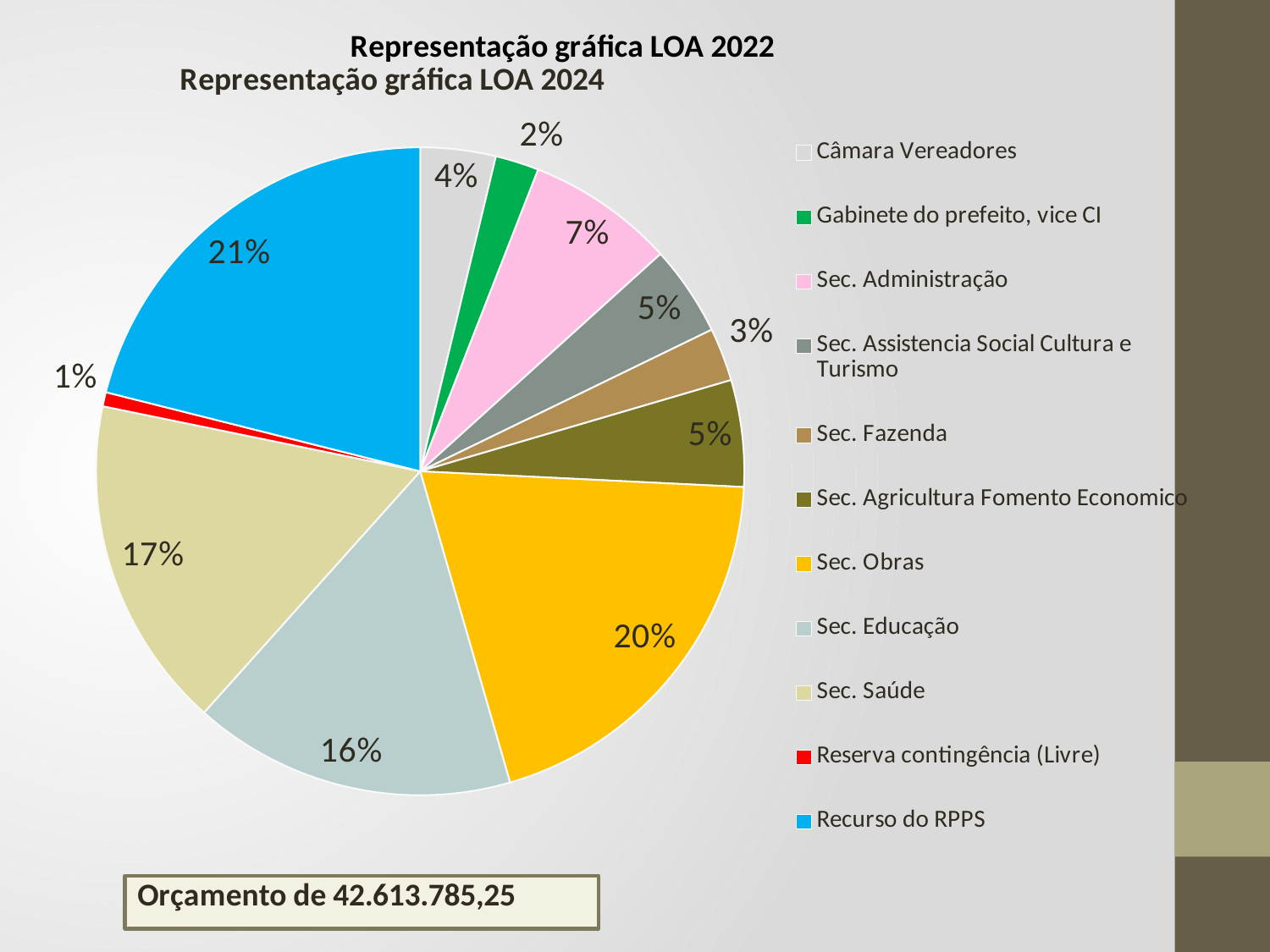
What percentage is shown for Câmara Vereadores? 4% How many categories does the legend list? 11 What percentage is shown for Recurso do RPPS? 21% Which category has the smallest slice of the pie? Reserva contingência (Livre) What is the difference in percentage points between Sec. Obras and Sec. Educação? 4 Which is larger, the slice for Sec. Administração or the slice for Sec. Fazenda? Sec. Administração What percentage is shown for Sec. Educação? 16% What is the chart title shown above the pie? Representação gráfica LOA 2024 What share of the pie does Sec. Obras represent? 20% What type of chart is shown on the slide? pie chart What percentage is shown for Sec. Saúde? 17% Which category has the largest slice of the pie? Recurso do RPPS